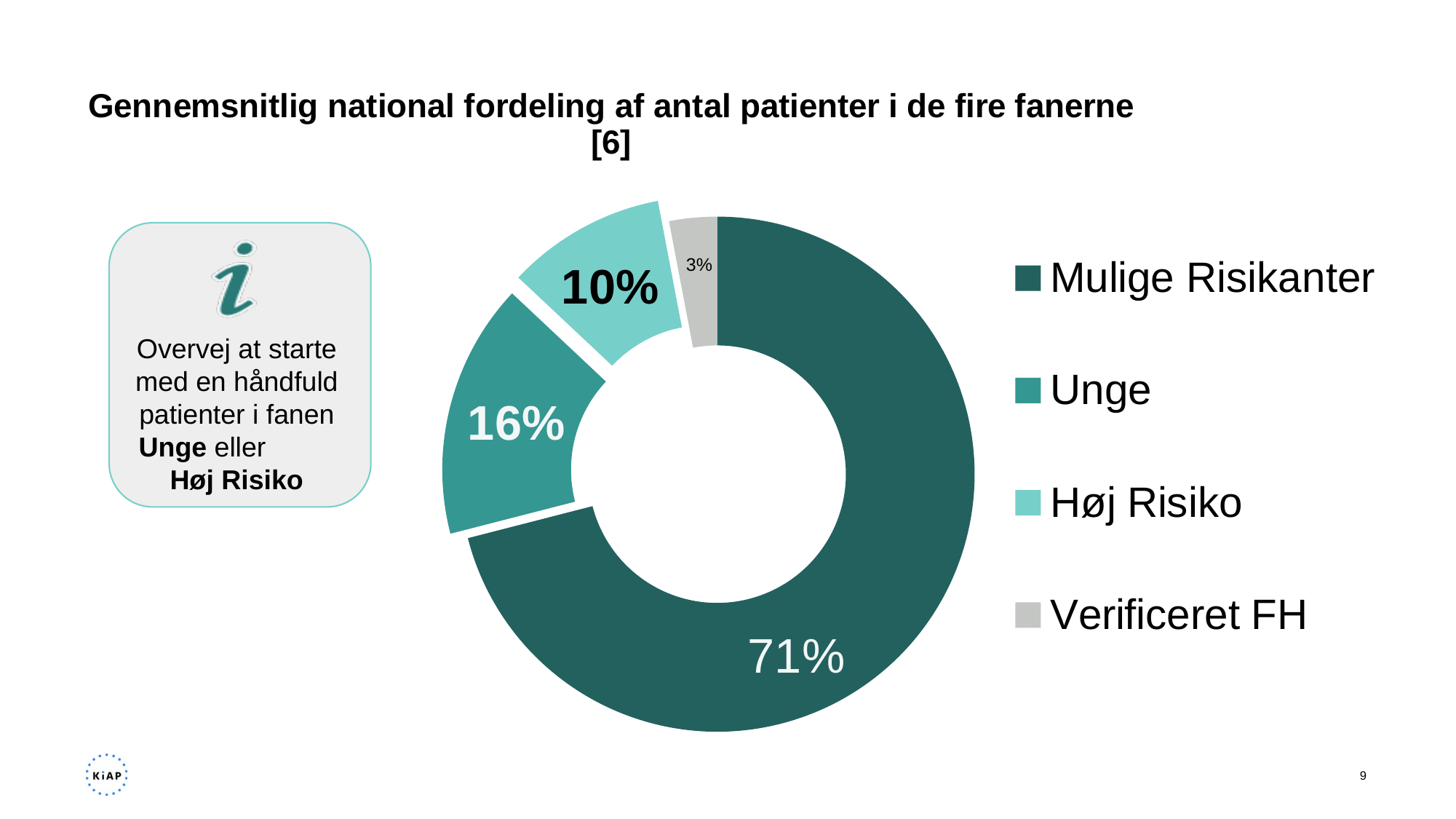
Which category has the smallest share of patients? Verificeret FH What percentage of patients are in the Høj Risiko category? 10% Which has a larger share, Unge or Høj Risiko? Unge What percentage of patients are in the Verificeret FH category? 3% What is the combined share of Unge and Høj Risiko? 26% What colour is the Verificeret FH slice? Grey Which category has the largest share of patients? Mulige Risikanter How many categories are shown in the chart? 4 What is the difference in percentage points between Unge and Høj Risiko? 6 What percentage of patients are in the Unge category? 16% What type of chart is shown on the slide? Doughnut (pie) chart What percentage of patients are in the Mulige Risikanter category? 71%